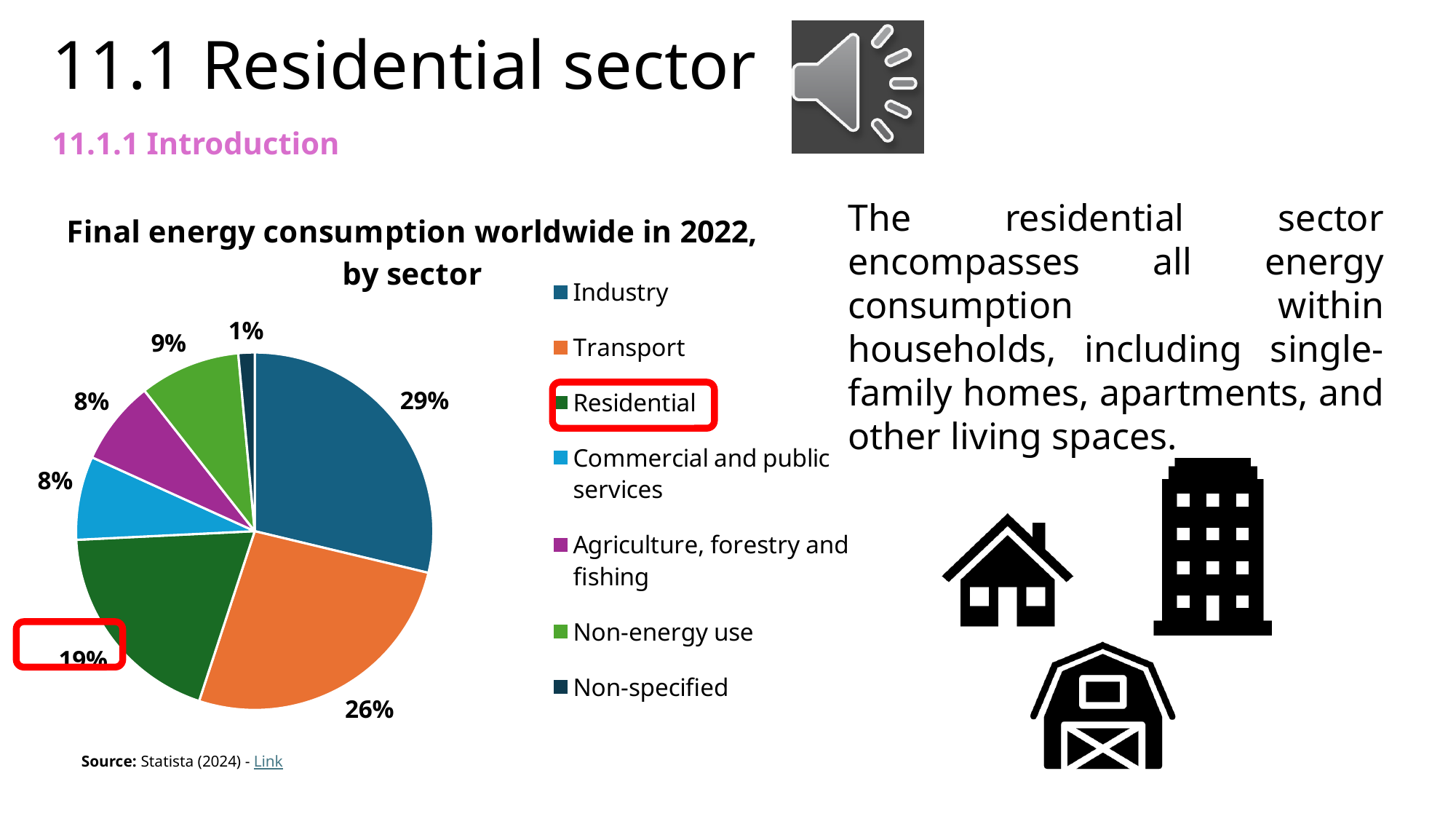
Which sector has a larger share, Transport or Residential? Transport What is the title of the chart? Final energy consumption worldwide in 2022, by sector Which sector has the smallest share of final energy consumption? Non-specified What type of chart is shown on the slide? Pie chart What share of final energy consumption does the Transport sector account for? 26% What share of final energy consumption does the Residential sector account for? 19% What share of final energy consumption does the Industry sector account for? 29% Which legend entry is highlighted with a red box? Residential How many sectors are listed in the legend? 7 What is the difference in percentage points between the Industry and Residential shares? 10 Which sector has the largest share of final energy consumption? Industry What share of final energy consumption does Non-energy use account for? 9%